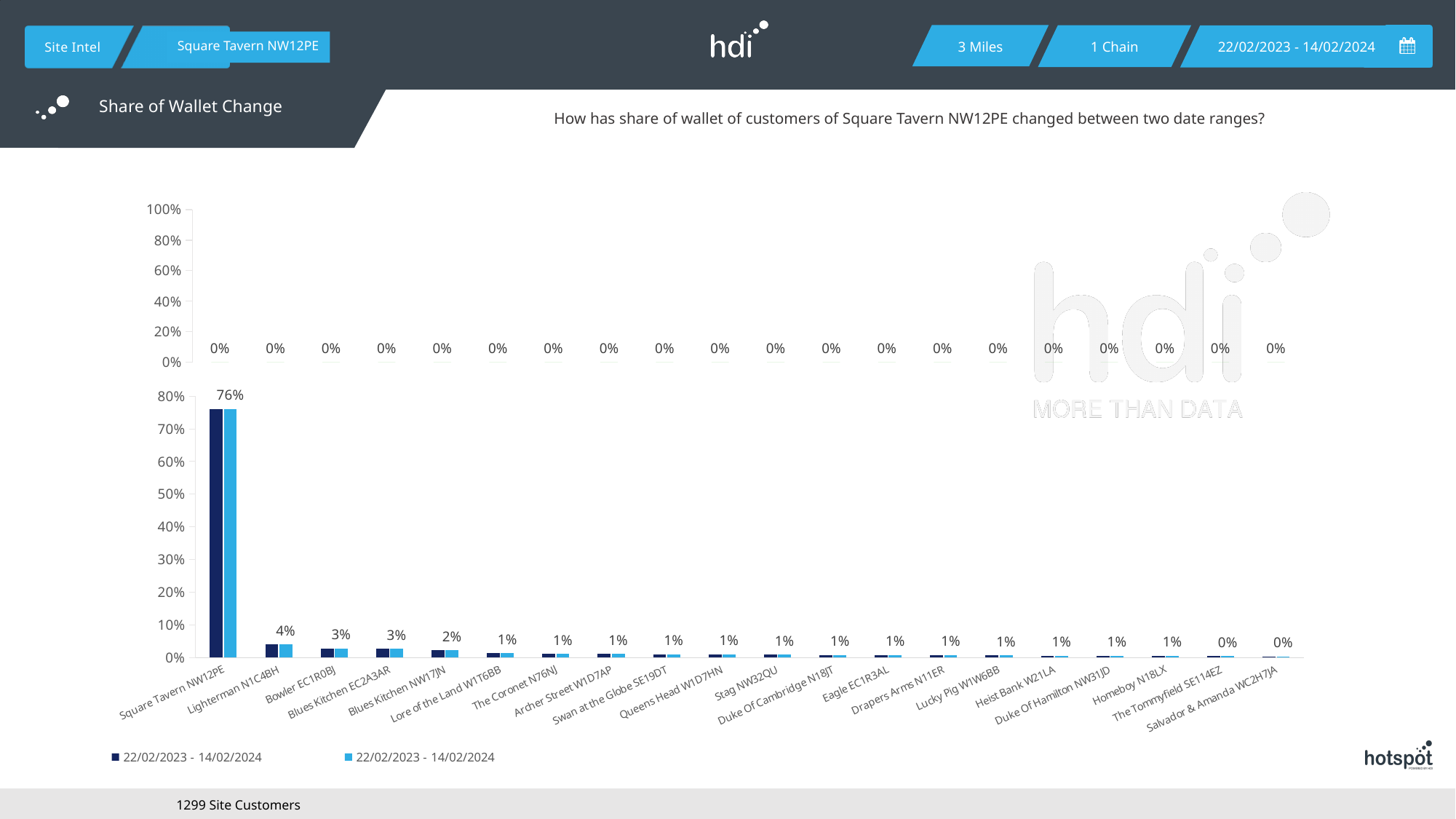
What kind of chart is the bottom chart? bar chart In the bottom chart, is the value for Square Tavern NW12PE greater or less than 70%? greater How many categories are shown along the x axis of the bottom chart? 20 In the bottom chart, what is the difference between the values for Square Tavern NW12PE and Lighterman N1C4BH? 72% In the bottom chart, what value is labelled for Lighterman N1C4BH? 4% In the bottom chart, which category has the highest value? Square Tavern NW12PE How many series does the legend list? 2 What is the title of the slide section shown at the top left? Share of Wallet Change In the bottom chart, what value is labelled for Blues Kitchen NW17JN? 2% In the bottom chart, what is the share of wallet value shown for Square Tavern NW12PE? 76% In the bottom chart, which is larger: the value for Bowler EC1R0BJ or the value for Lore of the Land W1T6BB? Bowler EC1R0BJ